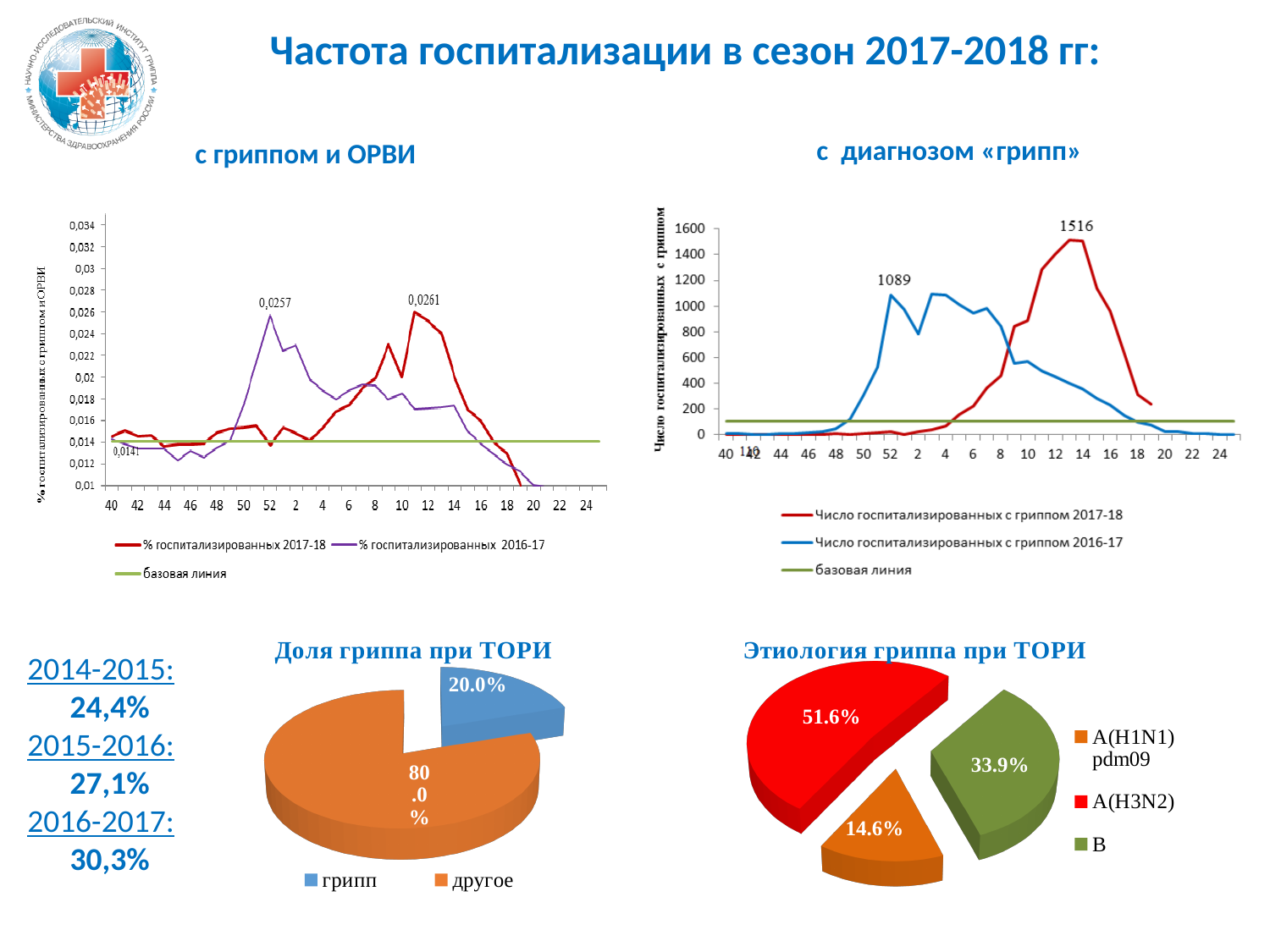
In the top-right chart «с диагнозом «грипп»», what is the peak value labelled for the 2017-18 series? 1516 In the top-left chart «с гриппом и ОРВИ», what value is labelled for the базовая линия? 0,0141 In the top-right chart «с диагнозом «грипп»», how many series does the legend list? 3 In the pie chart «Этиология гриппа при ТОРИ», which category has the smallest share? A(H1N1)pdm09 In the top-left chart «с гриппом и ОРВИ», what is the labelled peak value of the 2017-18 series? 0,0261 In the top-left chart «с гриппом и ОРВИ», what is the labelled peak value of the 2016-17 series? 0,0257 In the top-right chart «с диагнозом «грипп»», what is the difference between the labelled peaks of the 2017-18 and 2016-17 series? 427 In the pie chart «Доля гриппа при ТОРИ», what share is labelled for грипп? 20.0% In the pie chart «Доля гриппа при ТОРИ», which slice is larger, грипп or другое? другое What kind of chart is the top-left chart «с гриппом и ОРВИ»? line chart In the pie chart «Этиология гриппа при ТОРИ», what share is labelled for A(H3N2)? 51.6% In the top-right chart «с диагнозом «грипп»», what is the peak value labelled for the 2016-17 series? 1089